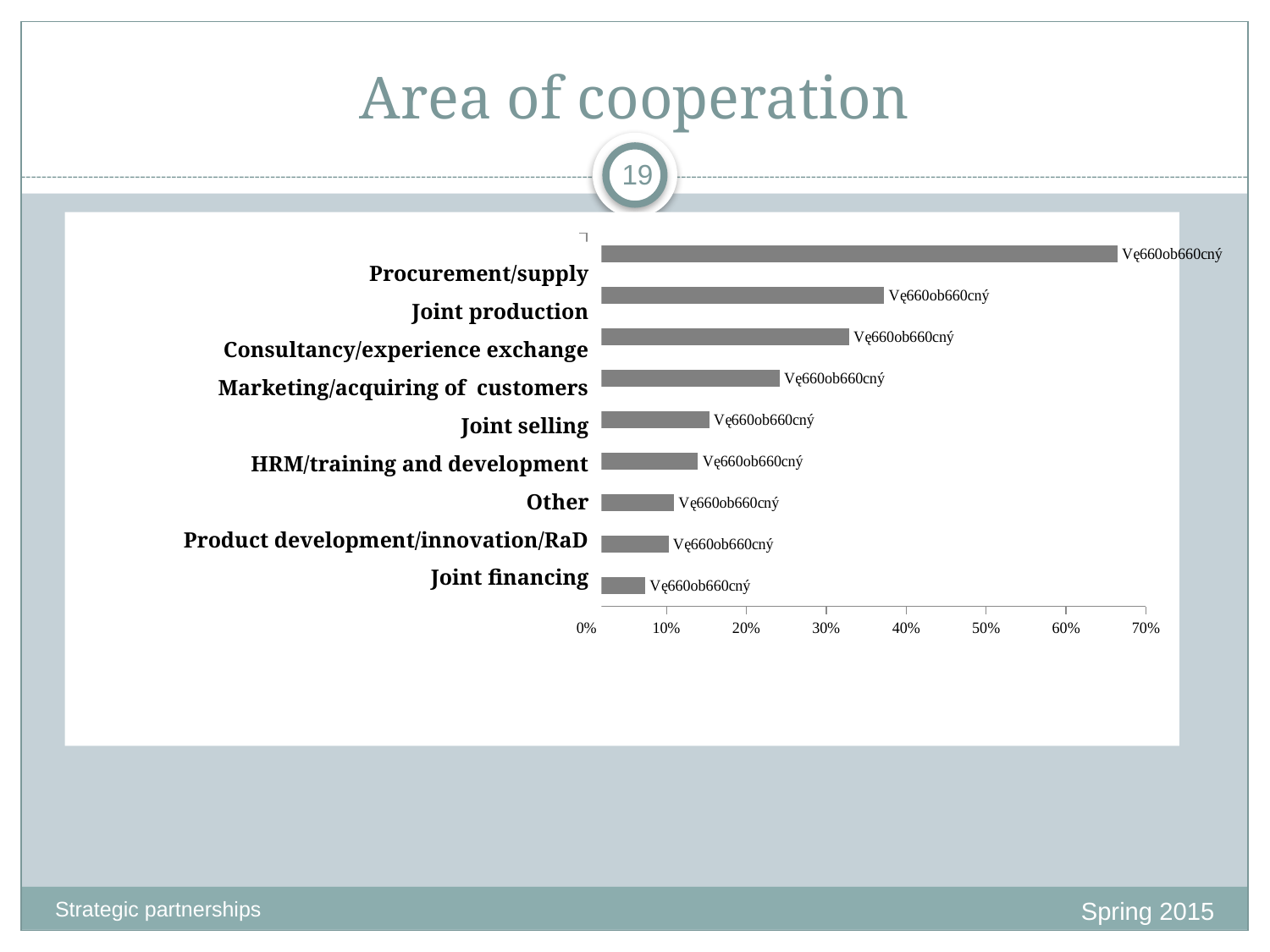
Which has a larger value, Joint production or Consultancy/experience exchange? Joint production Is the value for Joint production greater or less than 30%? greater Is the value for Procurement/supply greater or less than 60%? greater Is the value for Marketing/acquiring of customers greater or less than 20%? greater Which has a larger value, Marketing/acquiring of customers or Other? Marketing/acquiring of customers How many categories (areas of cooperation) are plotted in the chart? 9 Which area of cooperation has the lowest value in the chart? Joint financing Which area of cooperation has the highest value in the chart? Procurement/supply What kind of chart is shown on the slide? bar chart What is the title of the slide containing the chart? Area of cooperation